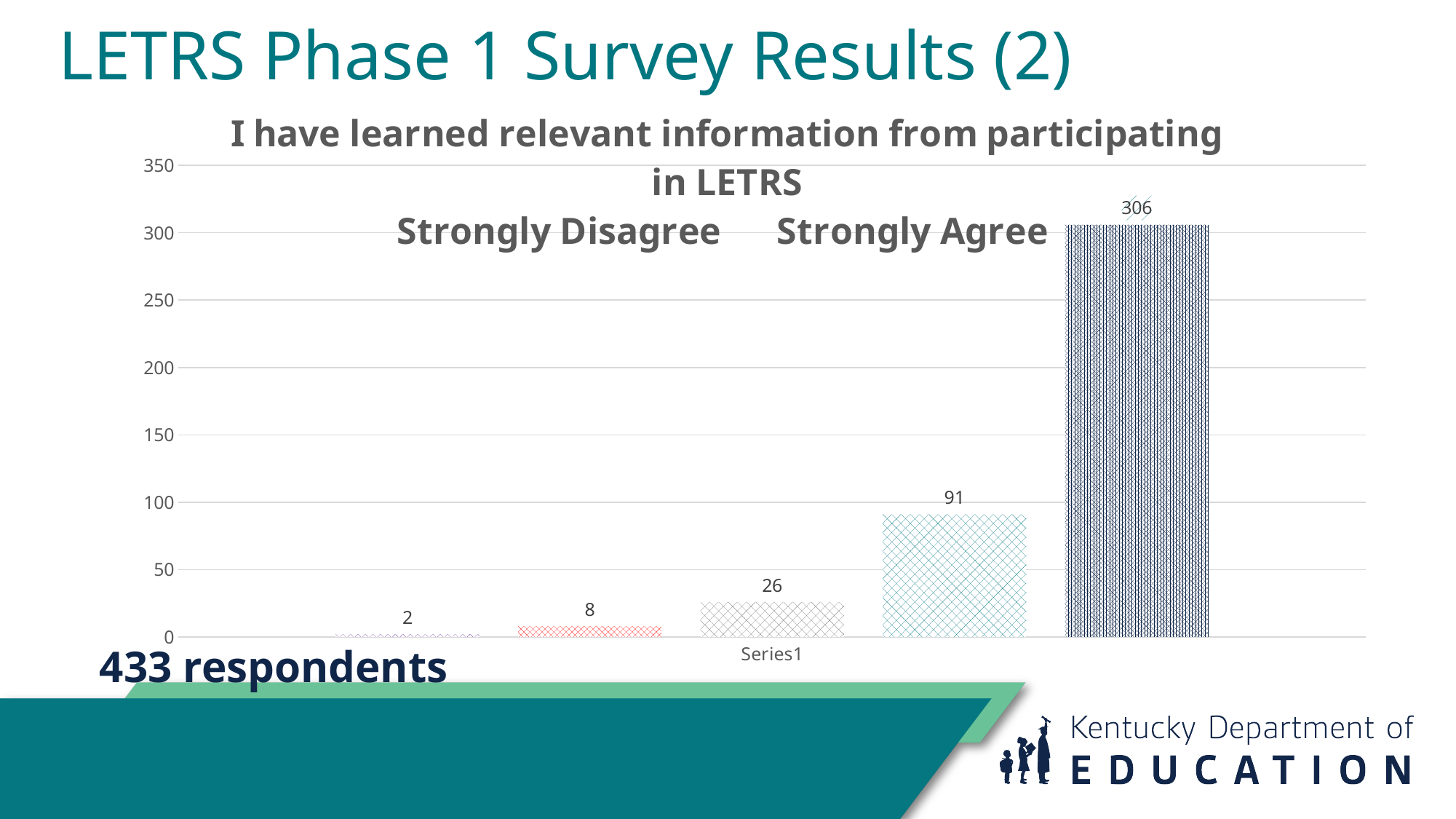
What is the value shown on the fourth bar from the left? 91 What is the value of the tallest bar in the chart? 306 What is the value shown on the third bar from the left? 26 What is the value of the shortest bar in the chart? 2 What is the value shown on the second bar from the left? 8 What label appears on the x axis beneath the bars? Series1 What kind of chart is shown on the slide? bar chart Which is larger, the second bar from the left or the third bar from the left? the third bar (26) How many bars are plotted in the chart? 5 What is the difference between the tallest bar (306) and the second tallest bar (91)? 215 What is the total of all five bar values in the chart? 433 Do the bar values rise or fall from left to right across the chart? rise